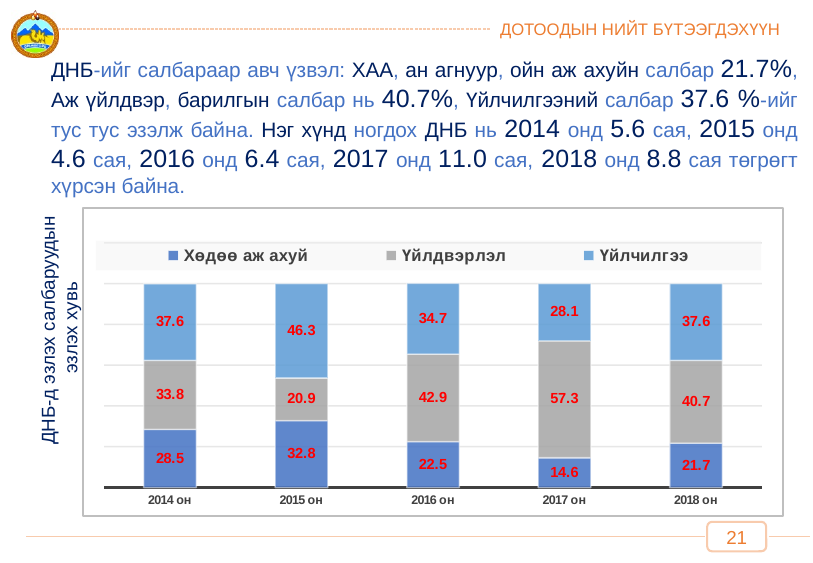
In which year is the Хөдөө аж ахуй value lowest? 2017 он In which year is the Үйлдвэрлэл value highest? 2017 он How many years are shown on the x axis? 5 What is the value for Үйлчилгээ in 2016 он? 34.7 How many series does the legend list? 3 What is the value for Үйлдвэрлэл in 2015 он? 20.9 Which series is shown in gray in the chart? Үйлдвэрлэл Which is larger, the Үйлдвэрлэл value in 2016 он or in 2018 он? 2016 он What is the value for Хөдөө аж ахуй in 2017 он? 14.6 What type of chart is shown on the slide? stacked bar chart What is the difference between the Үйлчилгээ values for 2015 он and 2017 он? 18.2 What is the total of the stacked bar for 2015 он? 100.0